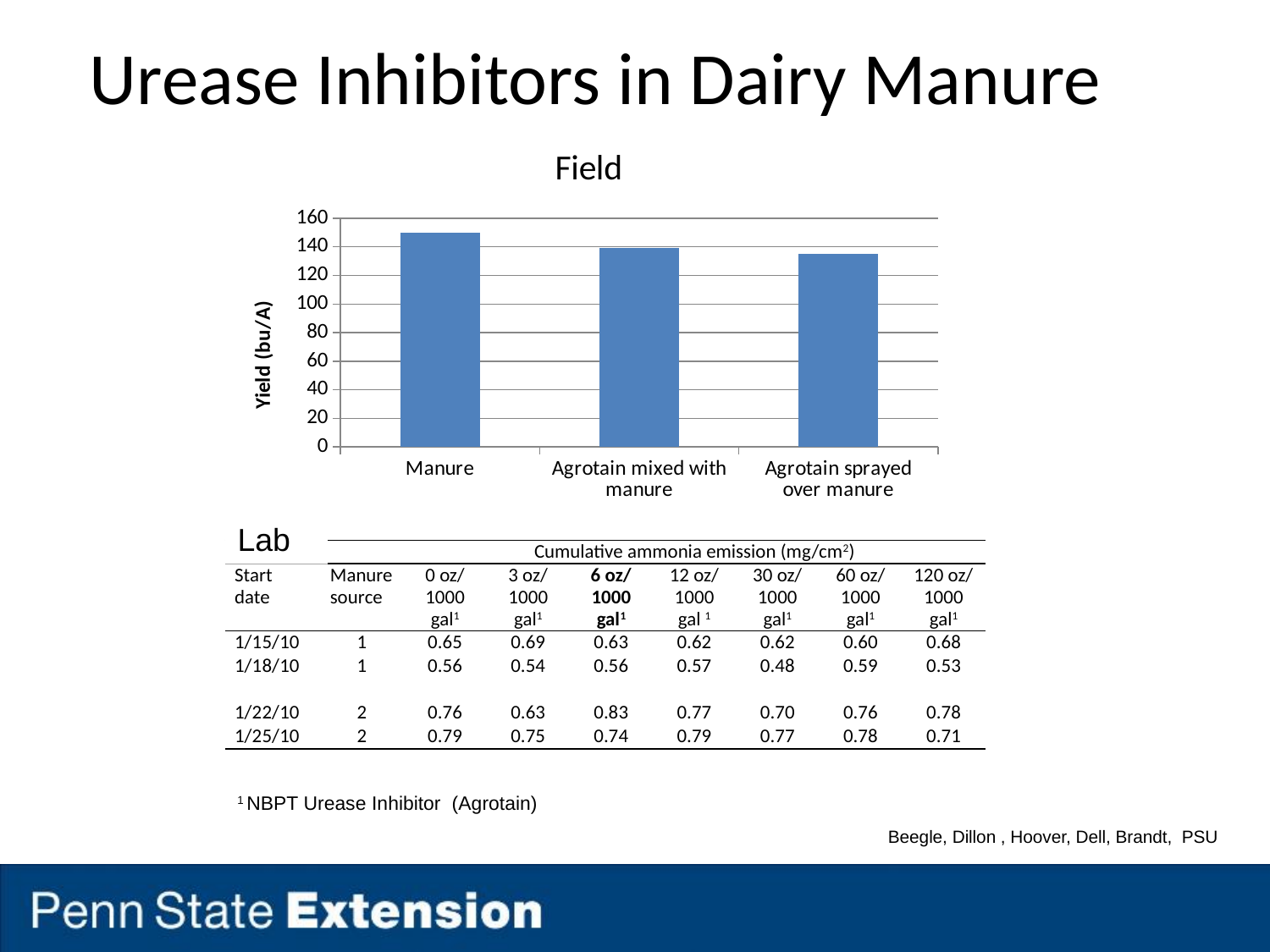
What is the title of the bar chart on the slide? Field Which has the larger yield, Manure or Agrotain sprayed over manure? Manure Which has the larger yield, Manure or Agrotain mixed with manure? Manure Do the yields rise or fall moving left to right across the categories in the Field chart? fall Is the yield for Manure greater or less than 140? greater What is the label on the vertical axis of the Field chart? Yield (bu/A) Is the yield for Agrotain mixed with manure greater or less than 120? greater What kind of chart is shown under the heading "Field"? bar chart Which category has the highest yield in the Field bar chart? Manure Is the yield for Agrotain sprayed over manure greater or less than 120? greater How many categories are plotted in the Field bar chart? 3